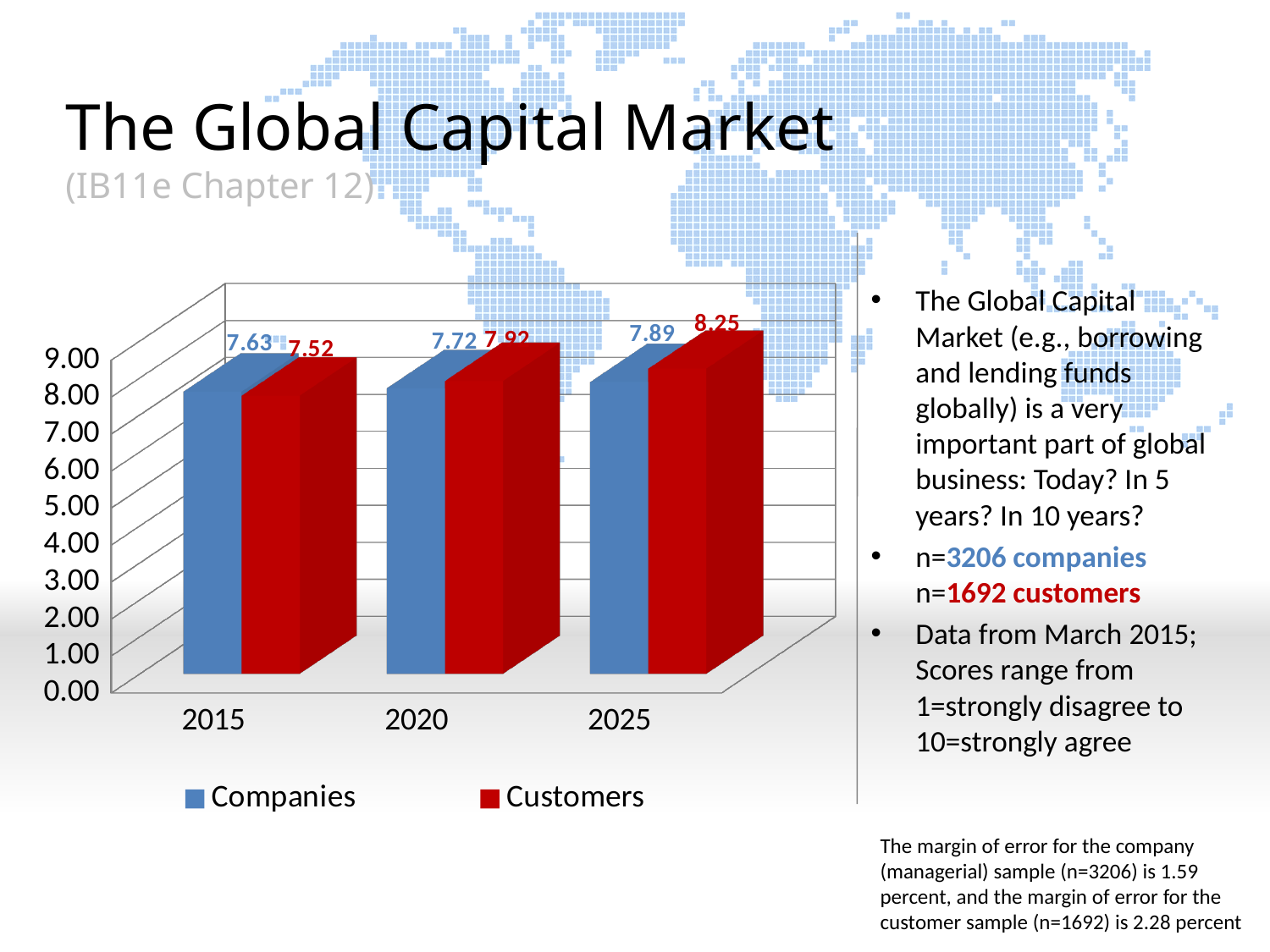
What is the value for Companies in 2025? 7.89 What is the value for Customers in 2015? 7.52 In 2015, which is larger: the Companies value or the Customers value? Companies In which year is the Companies value lowest? 2015 What is the value for Customers in 2025? 8.25 What is the value for Companies in 2015? 7.63 In which year is the Customers value highest? 2025 How many years are shown on the x axis? 3 How many series does the legend list? 2 What is the value for Companies in 2020? 7.72 What is the difference between the Customers value and the Companies value in 2025? 0.36 What kind of chart is shown on the slide? Bar chart